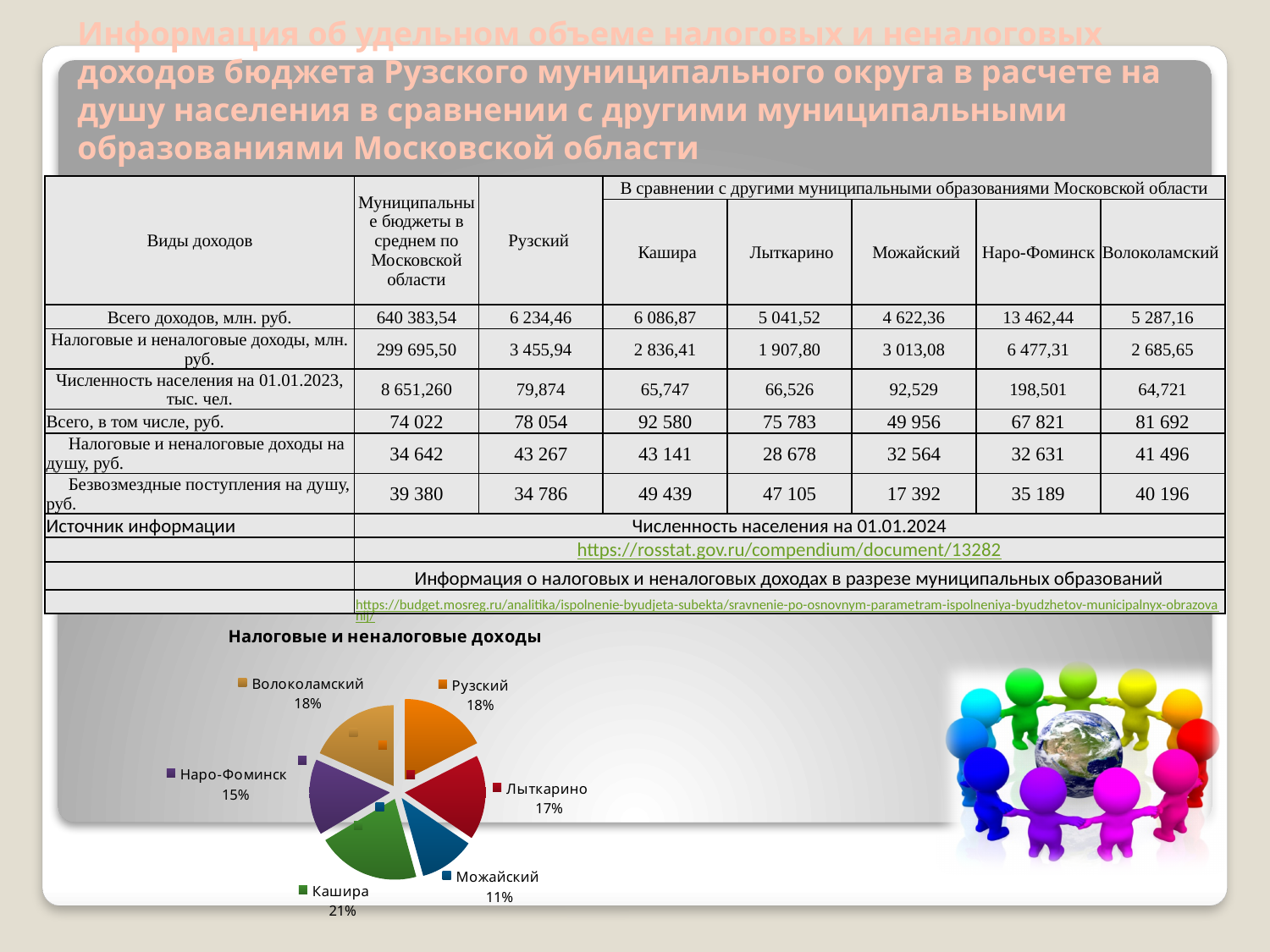
Which has a larger share in the pie chart, Кашира or Лыткарино? Кашира What share of the pie chart does Можайский have? 11% What share of the pie chart does Наро-Фоминск have? 15% Which slice of the pie chart is the largest? Кашира How many slices does the pie chart have? 6 What share of the pie chart does Рузский have? 18% What is the difference in percentage points between the shares of Кашира and Можайский? 10 What is the title of the pie chart? Налоговые и неналоговые доходы What type of chart is shown on the slide? pie chart Which slice of the pie chart is the smallest? Можайский